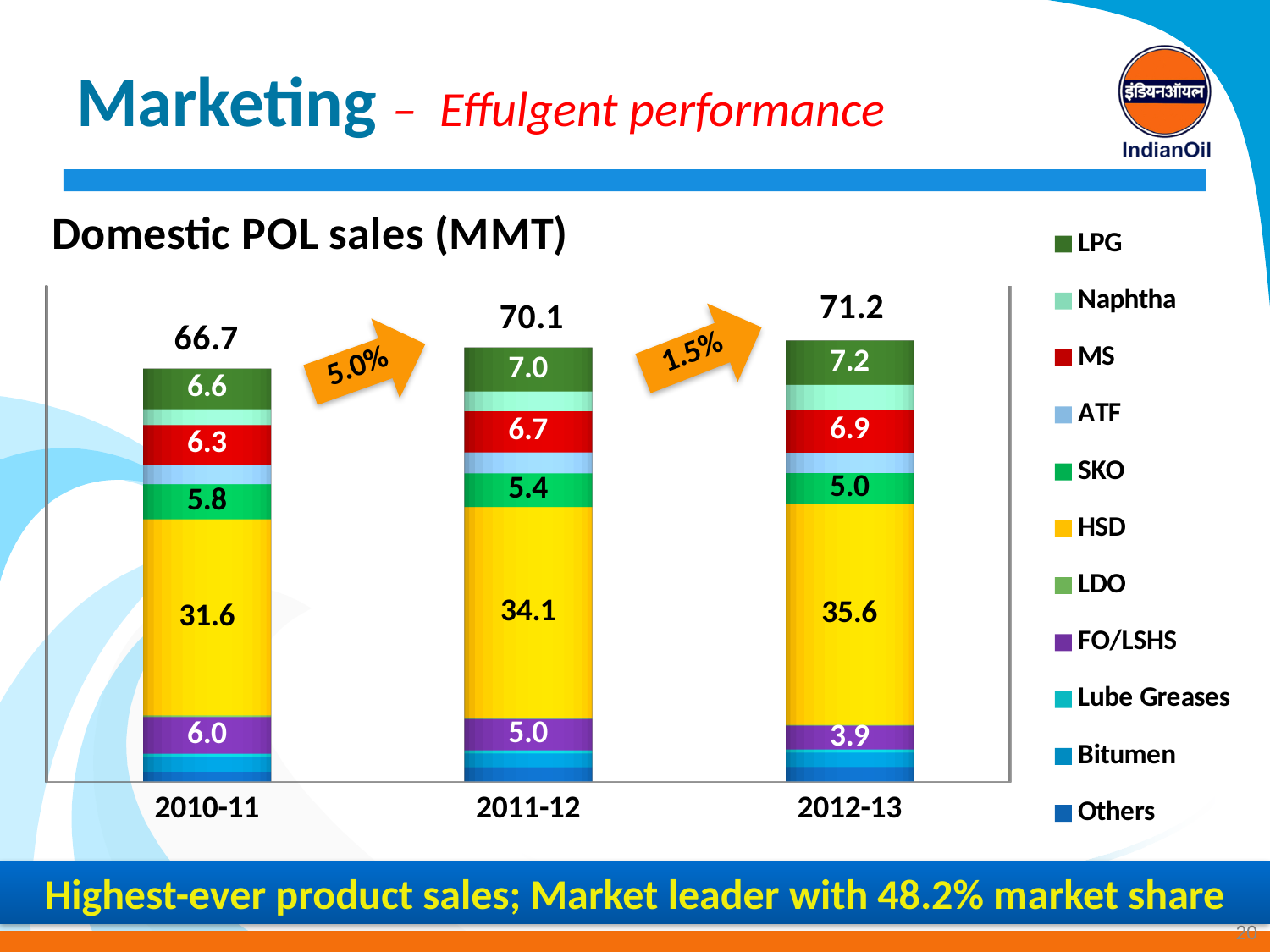
Which year has the lowest SKO value? 2012-13 What growth percentage is shown on the arrow between 2011-12 and 2012-13? 1.5% What is the LPG value for 2011-12? 7.0 What is the total domestic POL sales shown for 2010-11? 66.7 How many series does the legend list? 11 How many years are shown on the x axis? 3 What is the difference between the HSD values for 2011-12 and 2010-11? 2.5 What is the HSD value for 2012-13? 35.6 Is the FO/LSHS value larger in 2010-11 or in 2012-13? 2010-11 Do the total domestic POL sales rise or fall from 2010-11 to 2012-13? Rise Which year has the highest total domestic POL sales? 2012-13 What kind of chart is shown? Stacked bar chart